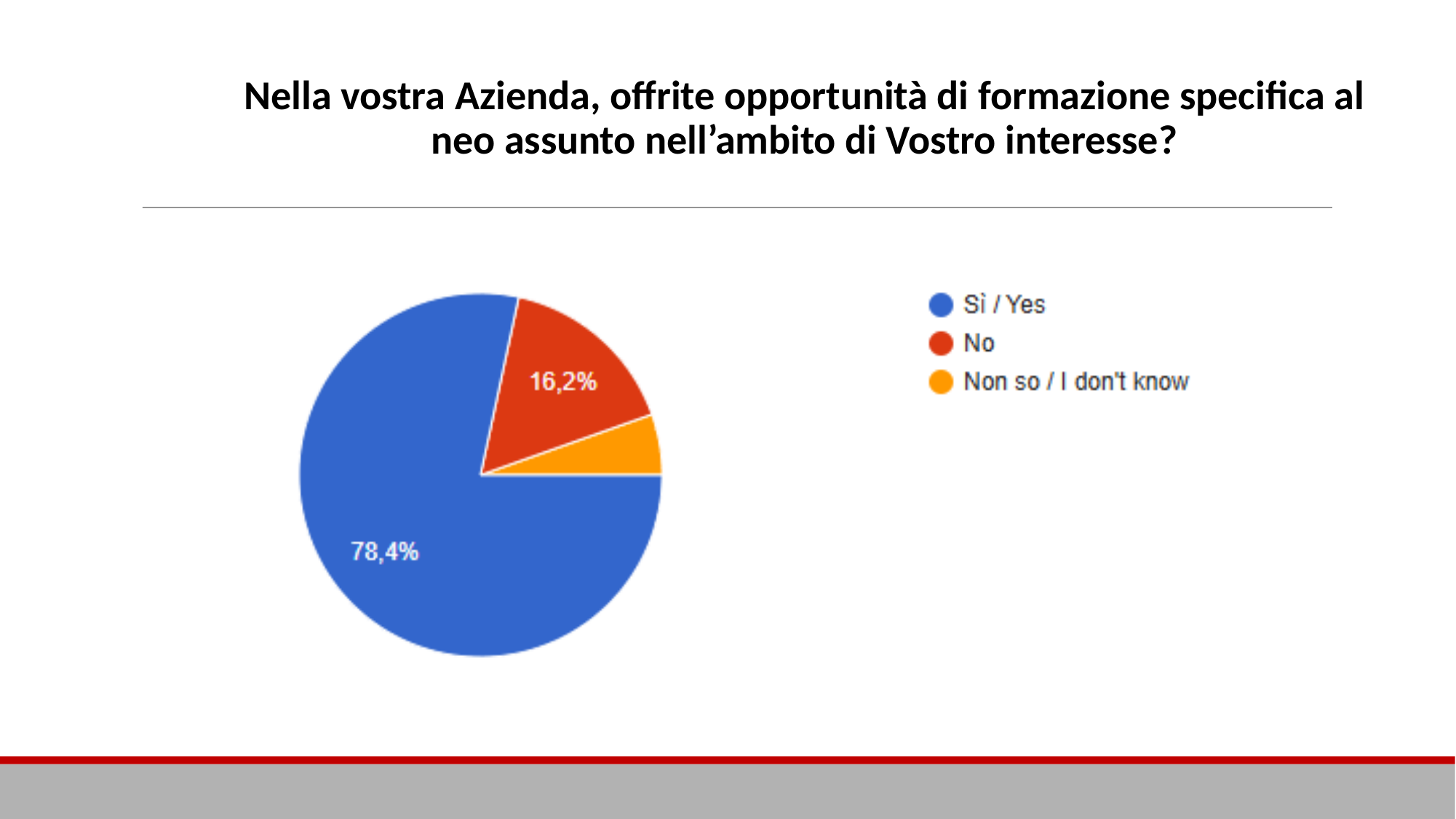
What colour is the "Non so / I don't know" slice? orange Is the share for "Sì / Yes" greater or less than 50%? greater What share of the pie does the "Sì / Yes" slice represent? 78,4% Which category has the largest slice of the pie? Sì / Yes What is the difference between the "Sì / Yes" share and the "No" share? 62,2% What is the value shown for the "No" slice? 16,2% What kind of chart is shown on the slide? pie chart Which legend entry is shown in blue? Sì / Yes Which category has the smallest slice of the pie? Non so / I don't know How many categories does the legend list? 3 Which is larger, the "No" slice or the "Non so / I don't know" slice? No